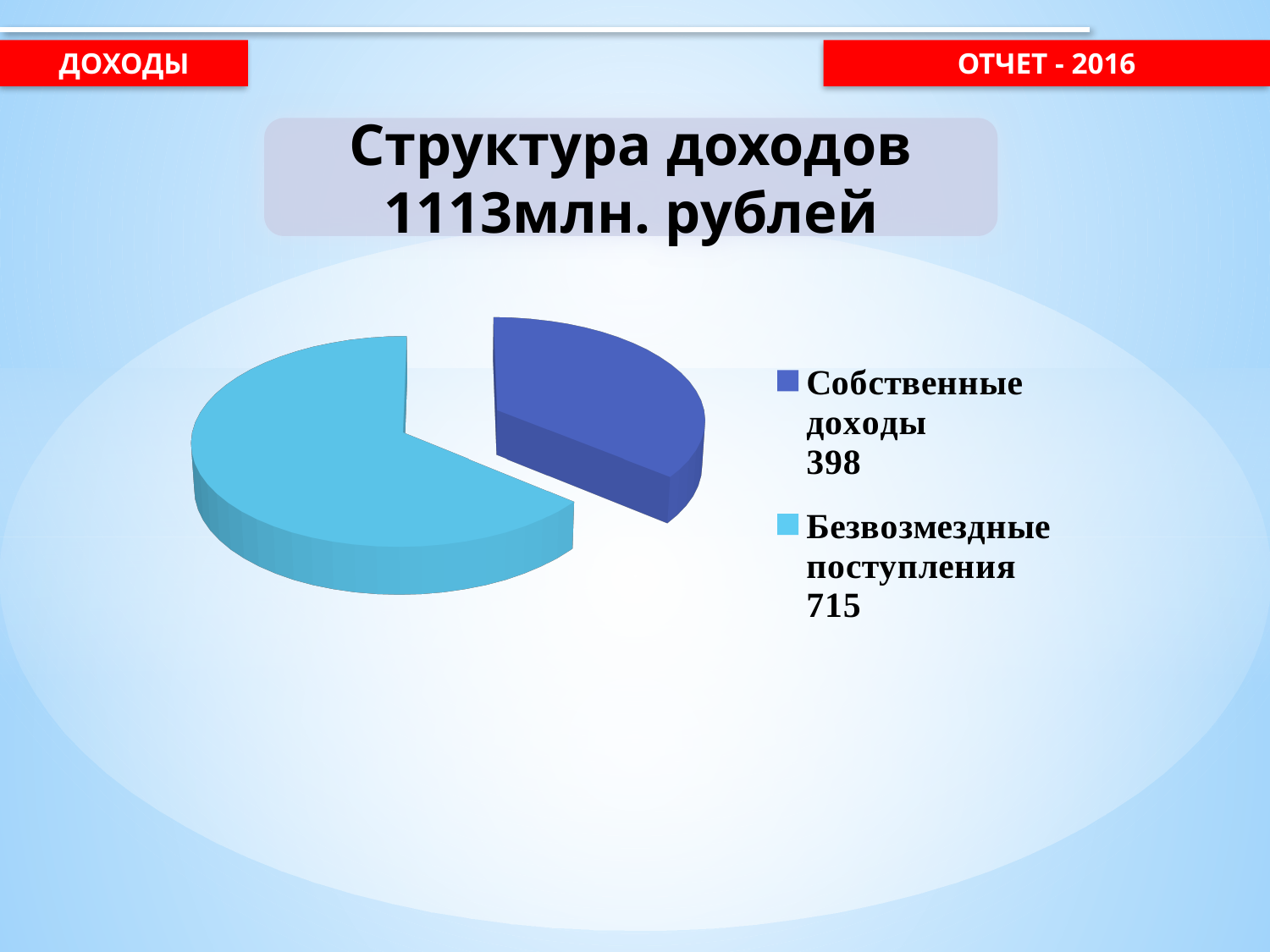
To the nearest whole percent, what share of the pie is Безвозмездные поступления? 64% What is the value for Безвозмездные поступления? 715 How many entries does the legend list? 2 How many slices does the pie chart have? 2 Which is larger, Собственные доходы or Безвозмездные поступления? Безвозмездные поступления What is the total of the two slices shown in the legend? 1113 What kind of chart is shown on the slide? Pie chart What is the difference between Безвозмездные поступления and Собственные доходы? 317 What is the title shown above the chart? Структура доходов 1113млн. рублей Which category has the smallest slice of the pie? Собственные доходы Which category has the largest slice of the pie? Безвозмездные поступления What is the value for Собственные доходы? 398